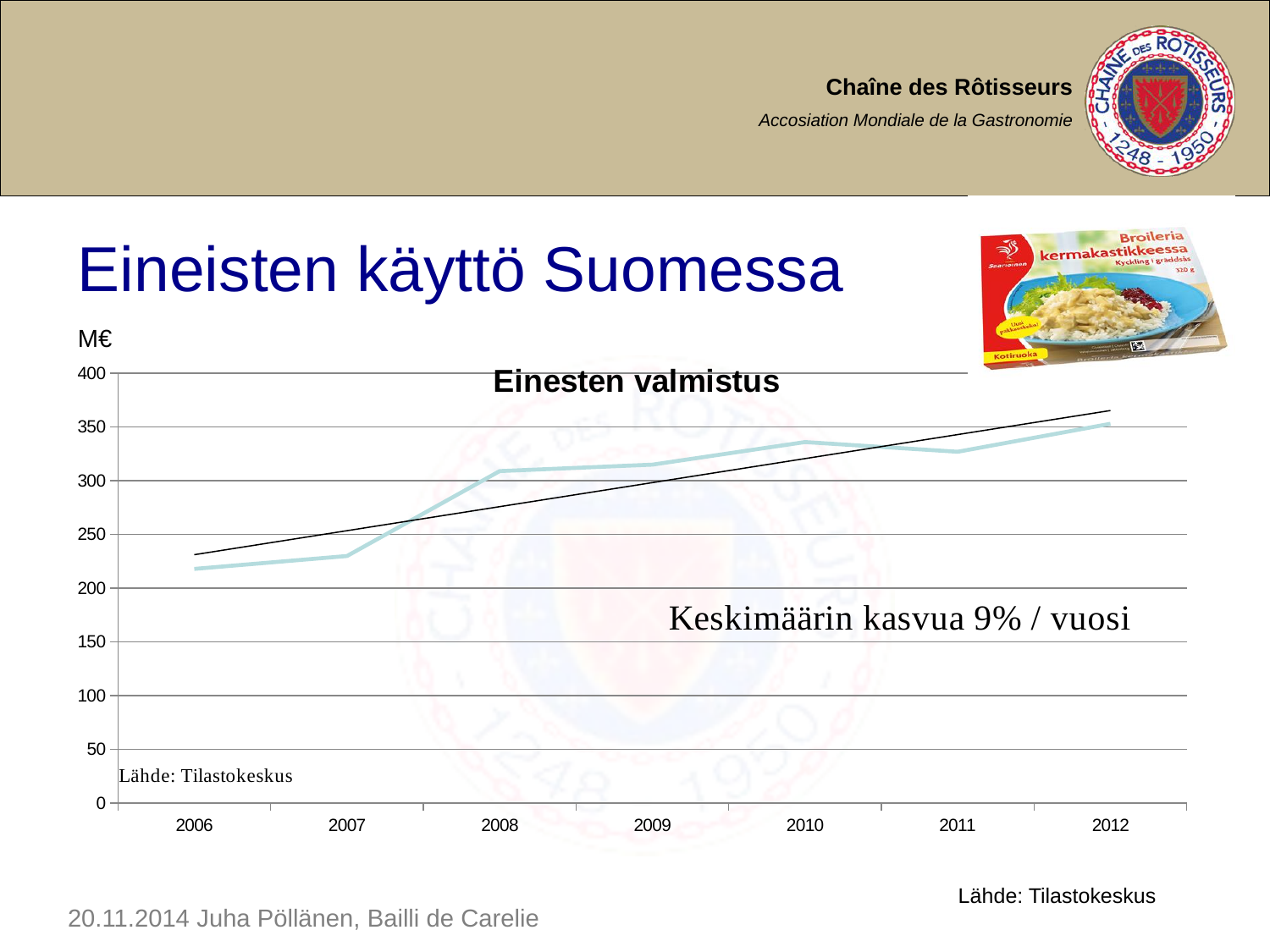
What kind of chart is shown on the slide? line chart How many years are plotted along the x axis of the chart? 7 What is the title of the chart? Einesten valmistus Is the value for 2008 greater or less than 300? greater Is the value for 2007 greater or less than 250? less Which year has the highest value on the chart? 2012 Is the value for 2012 greater or less than 300? greater Do the values generally rise or fall from 2006 to 2012? rise What unit is shown on the y axis of the chart? M€ Which year has the lowest value on the chart? 2006 Which year has the larger value, 2008 or 2007? 2008